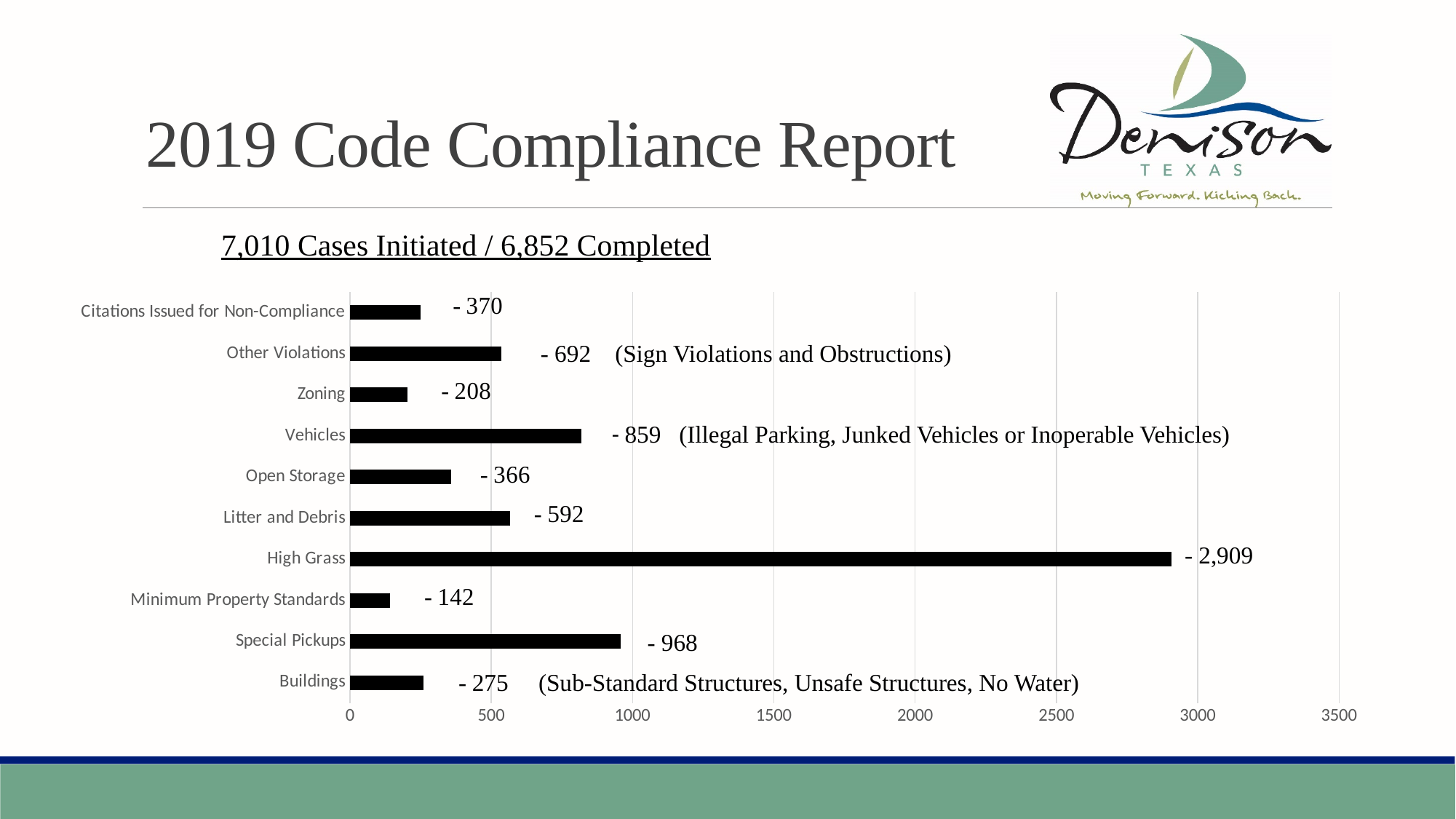
What kind of chart is shown on the slide? bar chart Which is larger, the value for Litter and Debris or the value for Open Storage? Litter and Debris What is the value for Zoning? 208 What is the difference between the values for Citations Issued for Non-Compliance and Buildings? 95 What is the value for Special Pickups? 968 How many categories are shown in the chart? 10 What is the highest value shown on the x axis? 3500 Which category has the highest value? High Grass What is the difference between the values for Vehicles and Other Violations? 167 Which category has the lowest value? Minimum Property Standards What is the value for High Grass? 2,909 Is the value for Special Pickups greater or less than 1000? less